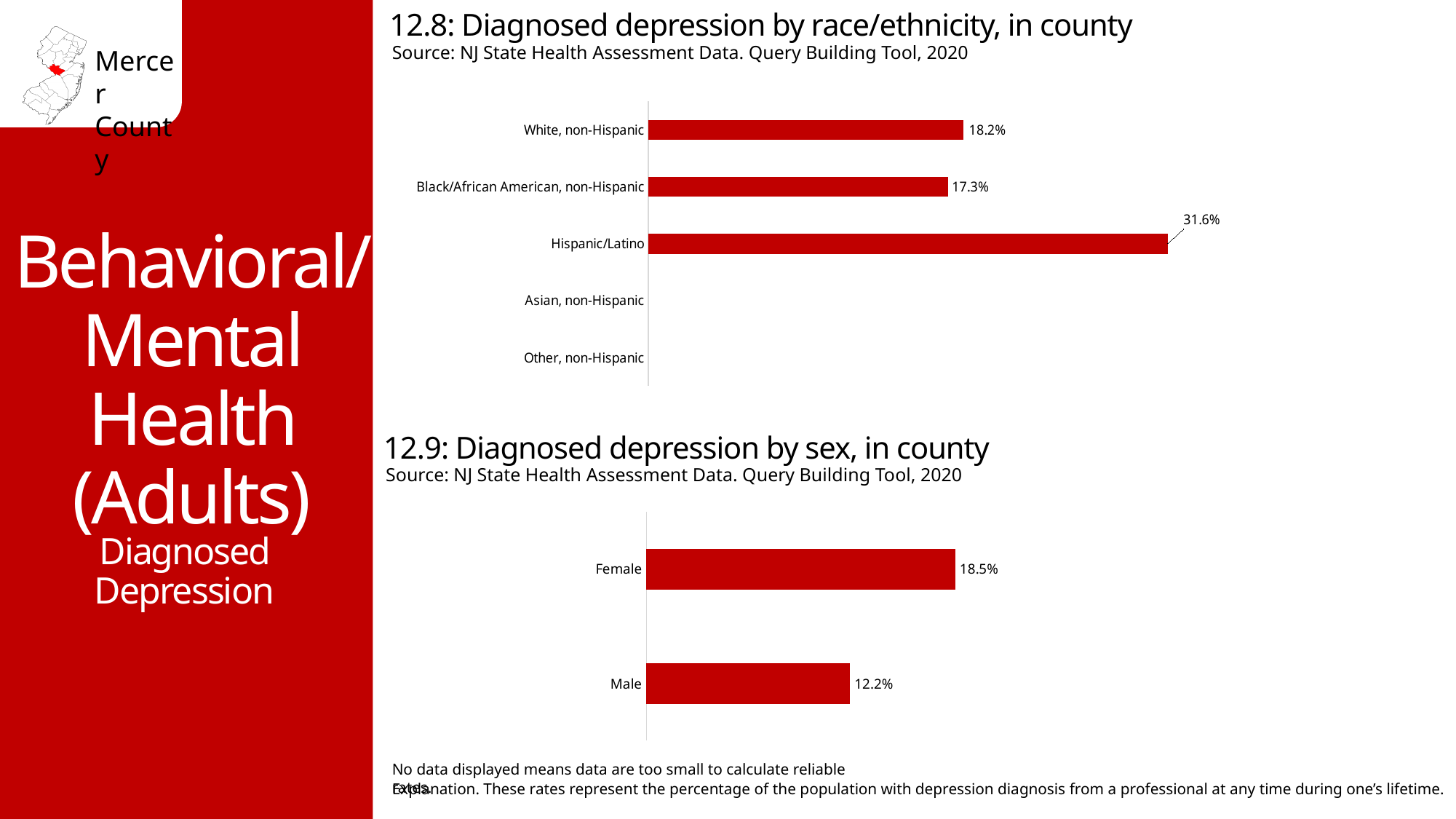
In the chart '12.8: Diagnosed depression by race/ethnicity, in county', how many category labels are listed on the axis? 5 In the chart '12.9: Diagnosed depression by sex, in county', which category has the lower value? Male In the chart '12.8: Diagnosed depression by race/ethnicity, in county', which categories have no bar displayed? Asian, non-Hispanic and Other, non-Hispanic In the chart '12.8: Diagnosed depression by race/ethnicity, in county', what is the value for White, non-Hispanic? 18.2% What kind of chart is '12.9: Diagnosed depression by sex, in county'? Bar chart In the chart '12.9: Diagnosed depression by sex, in county', what is the difference between the Female and Male values? 6.3% In the chart '12.8: Diagnosed depression by race/ethnicity, in county', what is the value for Black/African American, non-Hispanic? 17.3% In the chart '12.8: Diagnosed depression by race/ethnicity, in county', what is the value for Hispanic/Latino? 31.6% In the chart '12.8: Diagnosed depression by race/ethnicity, in county', what is the difference between the Hispanic/Latino value and the White, non-Hispanic value? 13.4% In the chart '12.9: Diagnosed depression by sex, in county', what is the value for Male? 12.2% In the chart '12.9: Diagnosed depression by sex, in county', what is the value for Female? 18.5% In the chart '12.8: Diagnosed depression by race/ethnicity, in county', which category has the highest value? Hispanic/Latino